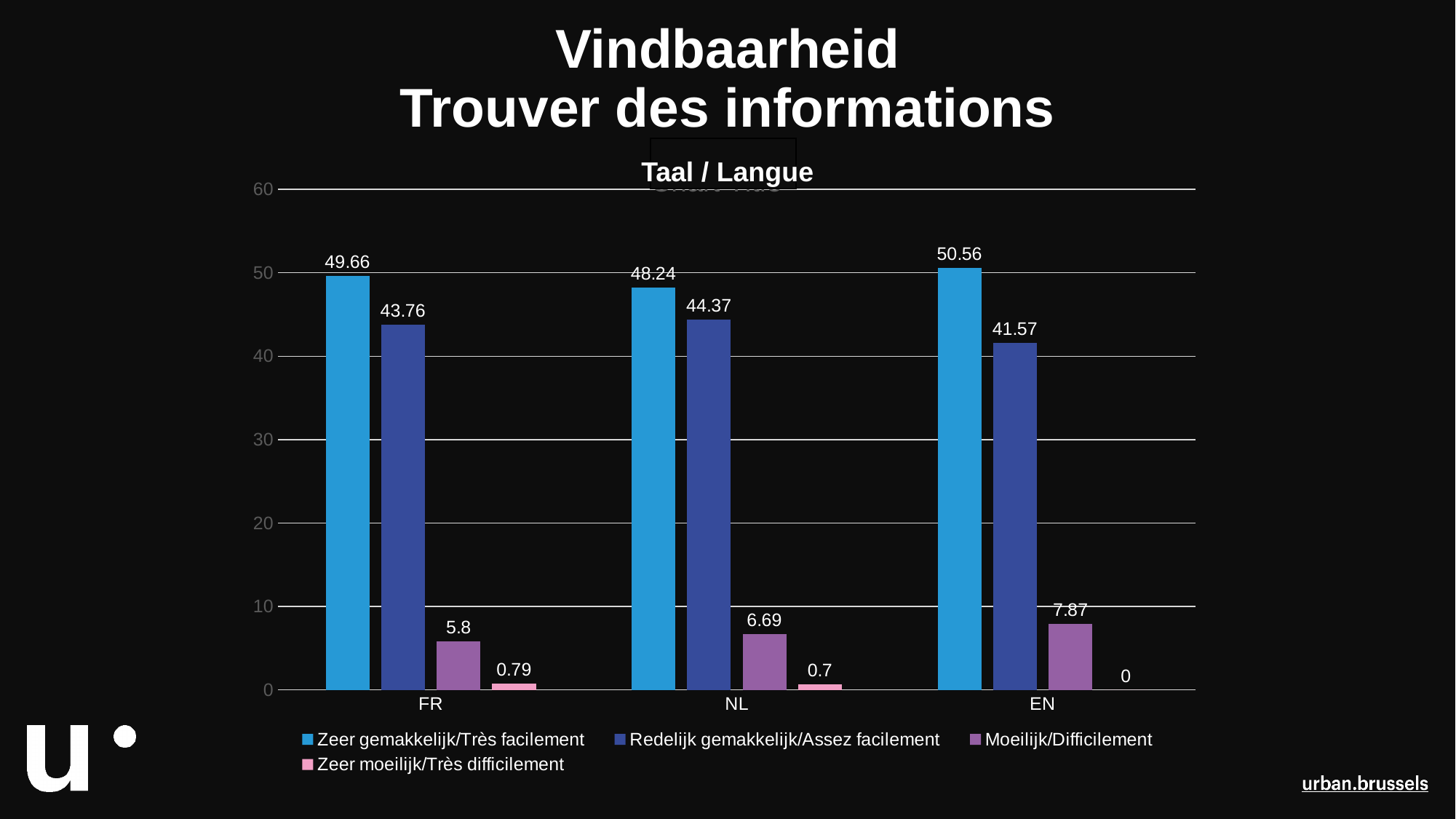
Which language has the highest value for 'Zeer gemakkelijk/Très facilement'? EN What is the difference between the 'Zeer gemakkelijk/Très facilement' and 'Redelijk gemakkelijk/Assez facilement' values for EN? 8.99 What is the value for 'Moeilijk/Difficilement' for EN? 7.87 What is the value for 'Zeer gemakkelijk/Très facilement' for FR? 49.66 What is the title shown above the chart's plot area? Taal / Langue What is the value for 'Zeer moeilijk/Très difficilement' for EN? 0 How many language categories are shown on the x axis? 3 Which language has the lowest value for 'Moeilijk/Difficilement'? FR How many series does the legend list? 4 Which is larger for NL: 'Zeer gemakkelijk/Très facilement' or 'Redelijk gemakkelijk/Assez facilement'? Zeer gemakkelijk/Très facilement What is the value for 'Redelijk gemakkelijk/Assez facilement' for NL? 44.37 What kind of chart is shown on the slide? Bar chart